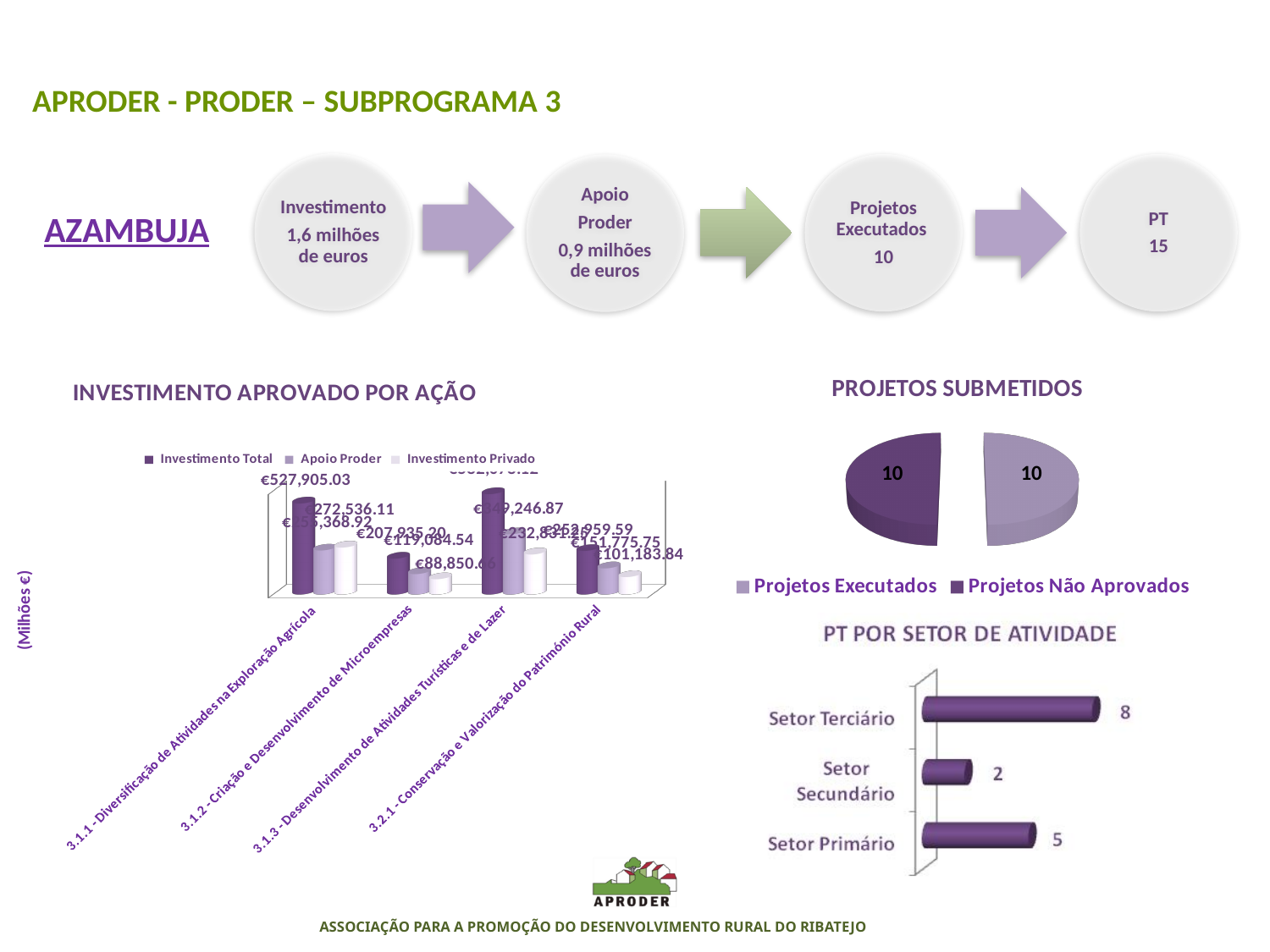
In the 'INVESTIMENTO APROVADO POR AÇÃO' chart, how many actions (categories) are shown on the x axis? 4 In the 'PT POR SETOR DE ATIVIDADE' chart, what is the value for Setor Terciário? 8 In the 'PT POR SETOR DE ATIVIDADE' chart, what is the value for Setor Primário? 5 What kind of chart is 'PT POR SETOR DE ATIVIDADE'? Bar chart In the 'PT POR SETOR DE ATIVIDADE' chart, which sector has the highest value? Setor Terciário How many series does the legend of the 'PROJETOS SUBMETIDOS' chart list? 2 In the 'PT POR SETOR DE ATIVIDADE' chart, which sector has the lowest value? Setor Secundário In the 'PROJETOS SUBMETIDOS' pie chart, what is the value for Projetos Executados? 10 In the 'PROJETOS SUBMETIDOS' pie chart, what share of the total do Projetos Não Aprovados represent? 50% In the 'INVESTIMENTO APROVADO POR AÇÃO' chart, what is the Investimento Total for 3.2.1 - Conservação e Valorização do Património Rural? €252,959.59 In the 'PT POR SETOR DE ATIVIDADE' chart, what is the difference between Setor Terciário and Setor Secundário? 6 How many series does the legend of the 'INVESTIMENTO APROVADO POR AÇÃO' chart list? 3